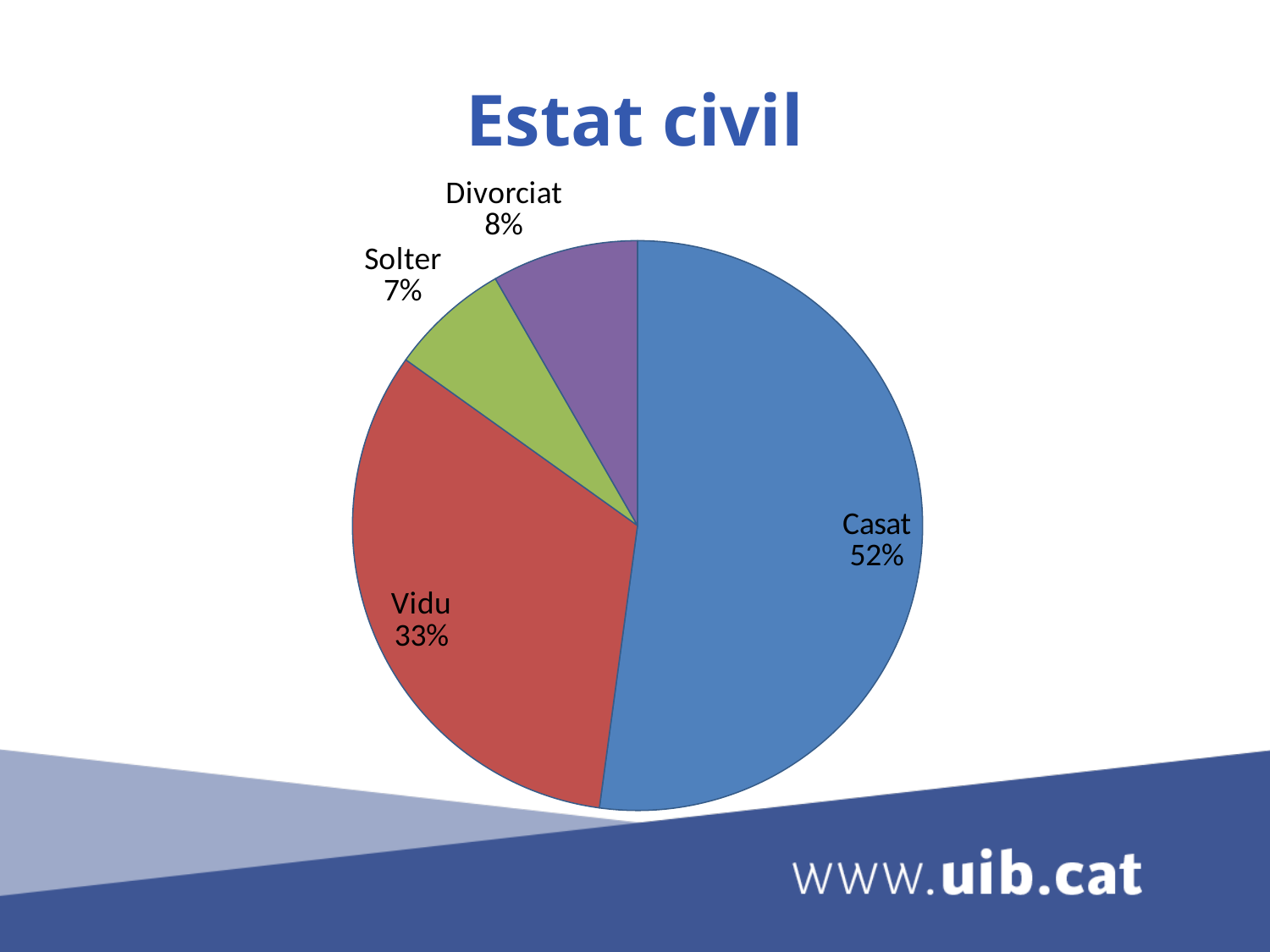
What type of chart is shown on the slide? pie chart What percentage is shown for Solter? 7% What colour is the Vidu slice? red What is the title of the chart? Estat civil What percentage is shown for Divorciat? 8% Which category has the largest share of the pie? Casat How many slices does the pie chart have? 4 What percentage is shown for Vidu? 33% What is the difference in percentage points between Casat and Vidu? 19 Which category has the smallest share of the pie? Solter Which is larger, the share for Vidu or the share for Divorciat? Vidu What percentage is shown for Casat? 52%